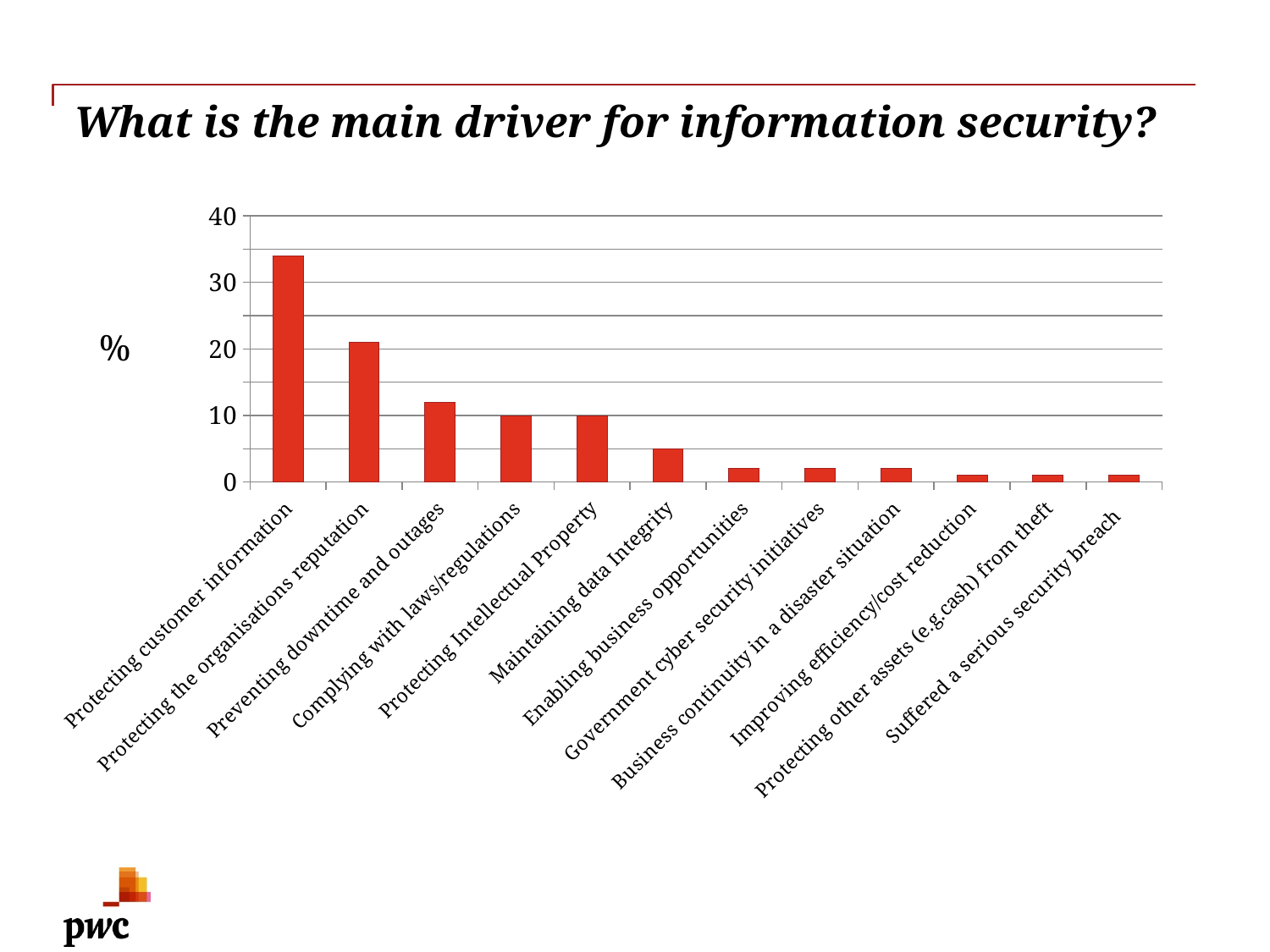
Is the value for Protecting customer information greater or less than 30? greater What is the title of the chart? What is the main driver for information security? Do the values rise or fall moving from left to right along the x axis? fall Which category has the highest value? Protecting customer information Is the value for Preventing downtime and outages greater or less than 10? greater Which is larger, the value for Protecting the organisations reputation or the value for Preventing downtime and outages? Protecting the organisations reputation How many categories are plotted on the chart? 12 Which is larger, the value for Protecting Intellectual Property or the value for Maintaining data Integrity? Protecting Intellectual Property What kind of chart is shown on the slide? bar chart Is the value for Maintaining data Integrity greater or less than 10? less